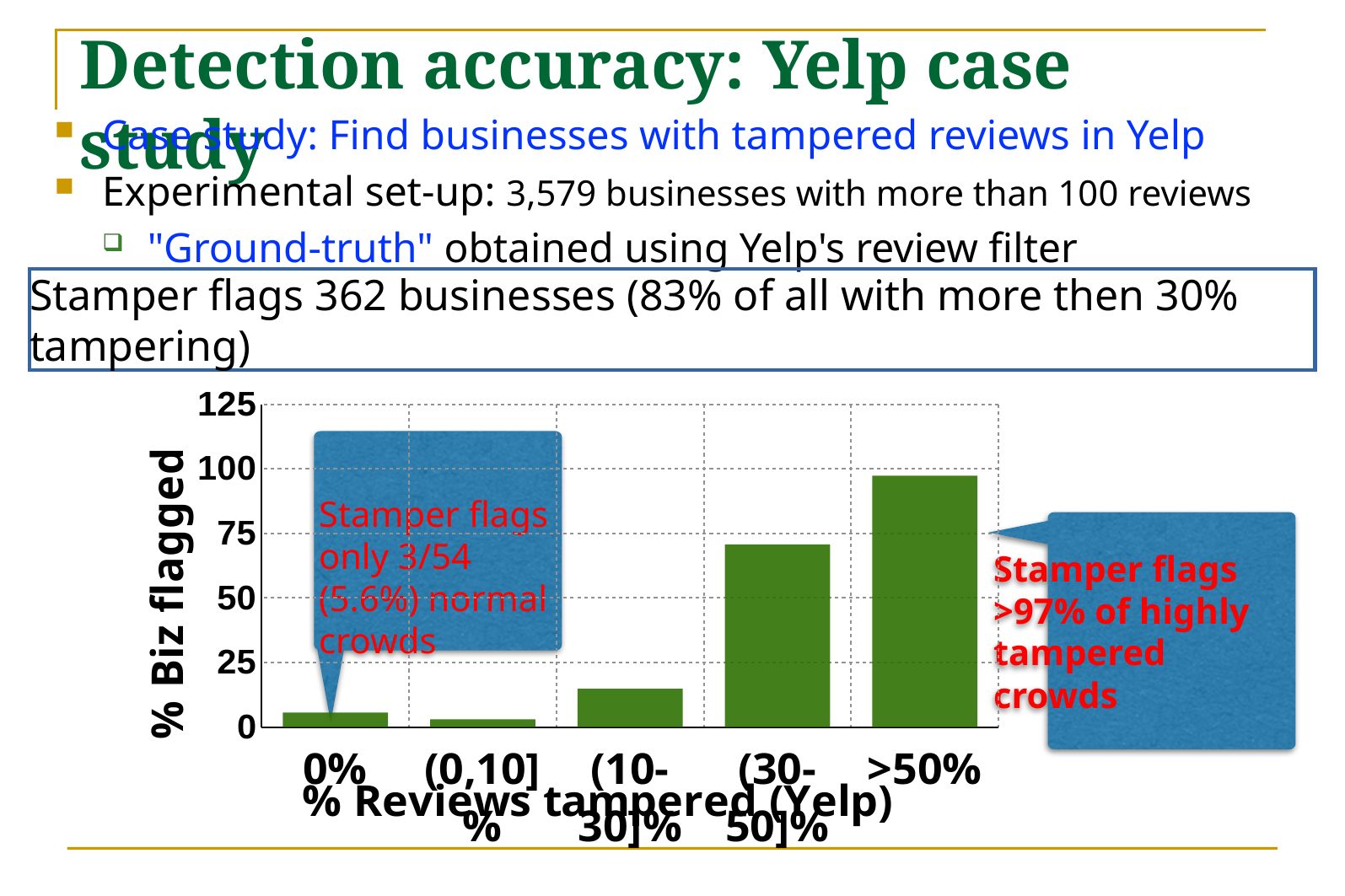
Which category has the highest % Biz flagged? >50% What is the title of the y axis of the chart? % Biz flagged Do the values generally rise or fall as the % of reviews tampered increases along the x axis? rise Is the value for 0% greater or less than 25? less Which is larger, the value for >50% or the value for (30-50]%? >50% Is the value for (30-50]% greater or less than 50? greater Is the value for (10-30]% greater or less than 25? less Which is larger, the value for (30-50]% or the value for (10-30]%? (30-50]% How many categories are shown on the x axis of the chart? 5 What kind of chart is shown on the slide? bar chart